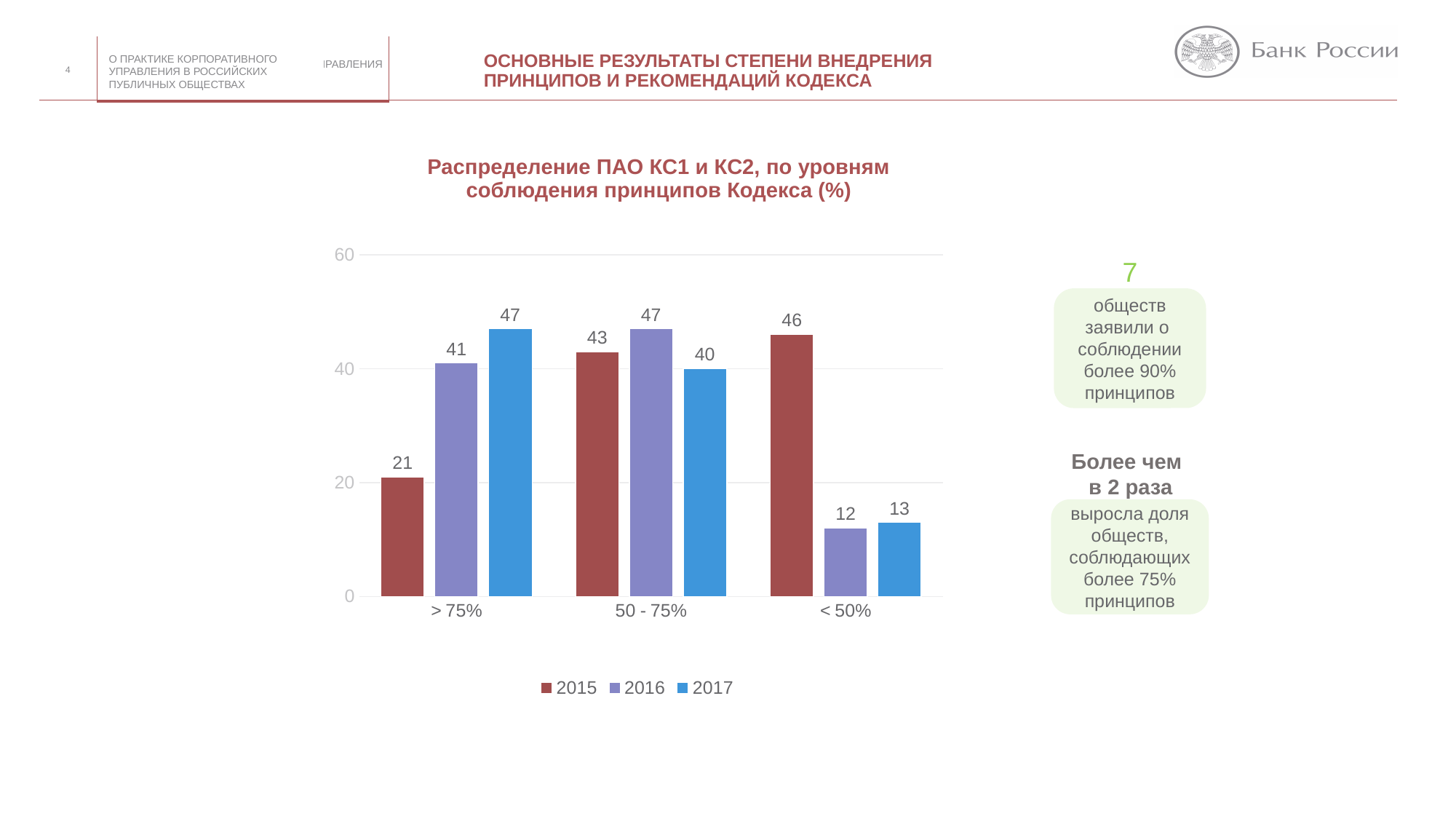
What is the value for 2016 in the "< 50%" category? 12 Is the value for 2015 in the "< 50%" category greater or less than 40? greater How many series does the legend list? 3 Which category has the lowest value for the 2017 series? < 50% How many categories are shown on the x axis? 3 What is the difference between the 2017 and 2015 values in the "> 75%" category? 26 What is the value for 2015 in the "> 75%" category? 21 Which is larger in the "50 - 75%" category: the 2015 value or the 2016 value? 2016 What kind of chart is shown on the slide? Bar chart Which category has the highest value for the 2015 series? < 50% What is the value for 2017 in the "50 - 75%" category? 40 Do the values for the 2015 series rise or fall from "> 75%" to "< 50%"? Rise